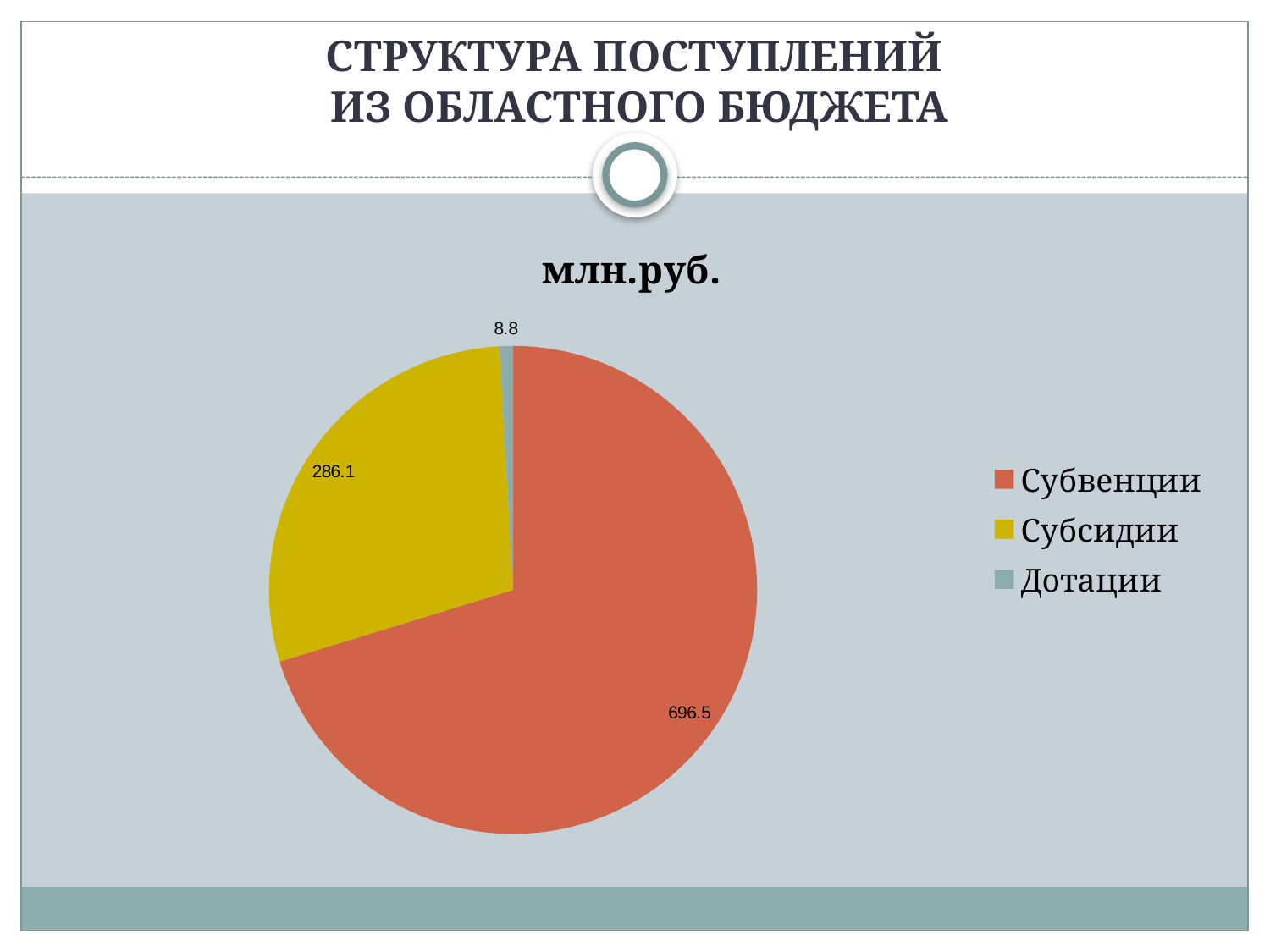
What is the difference between the values for Субвенции and Субсидии? 410.4 What is the value for Субвенции? 696.5 What kind of chart is shown on the slide? Pie chart How many slices does the pie chart have? 3 What is the title of the chart? млн.руб. How many entries does the legend list? 3 What is the value for Дотации? 8.8 Which is larger, the value for Субсидии or the value for Дотации? Субсидии Which category has the smallest slice of the pie? Дотации What is the total of all three slices? 991.4 What is the value for Субсидии? 286.1 Which category has the largest slice of the pie? Субвенции